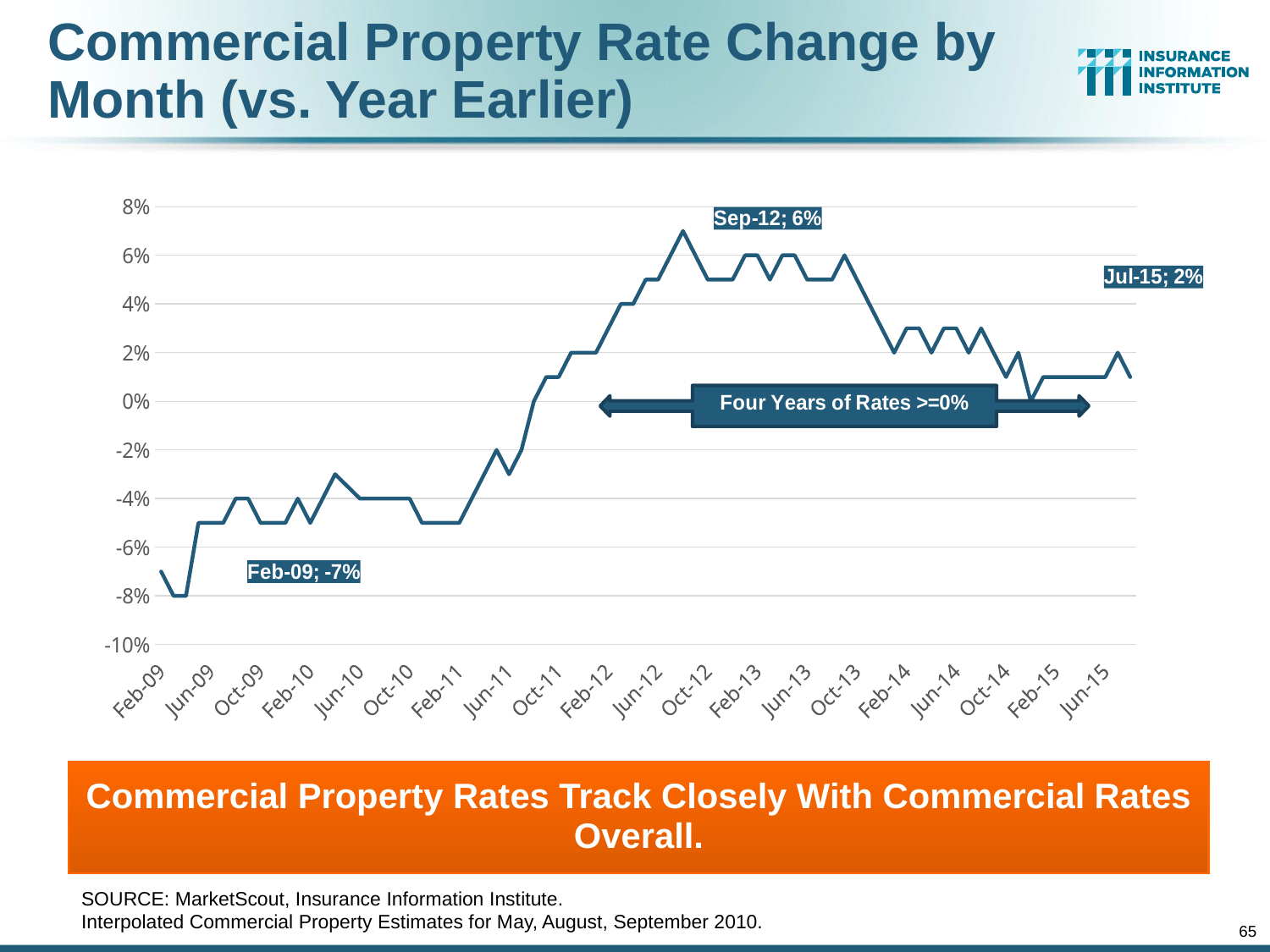
What is the difference between the labeled values for Sep-12 (6%) and Feb-09 (-7%)? 13 percentage points What is the commercial property rate change shown for Feb-09? -7% What kind of chart is shown on the slide? line chart Of the three labeled points (Feb-09, Sep-12, Jul-15), which has the highest value? Sep-12 What value is labeled for Sep-12 on the chart? 6% Which is larger, the labeled value for Jul-15 or for Feb-09? Jul-15 Is the value for Jun-14 greater or less than 0%? greater What does the arrow annotation in the middle of the chart say? Four Years of Rates >=0% Between Feb-11 and Jun-12, do the values generally rise or fall? rise Is the value for Feb-10 greater or less than -2%? less Is the value for Jun-12 greater or less than 2%? greater What is the rate change labeled for Jul-15? 2%